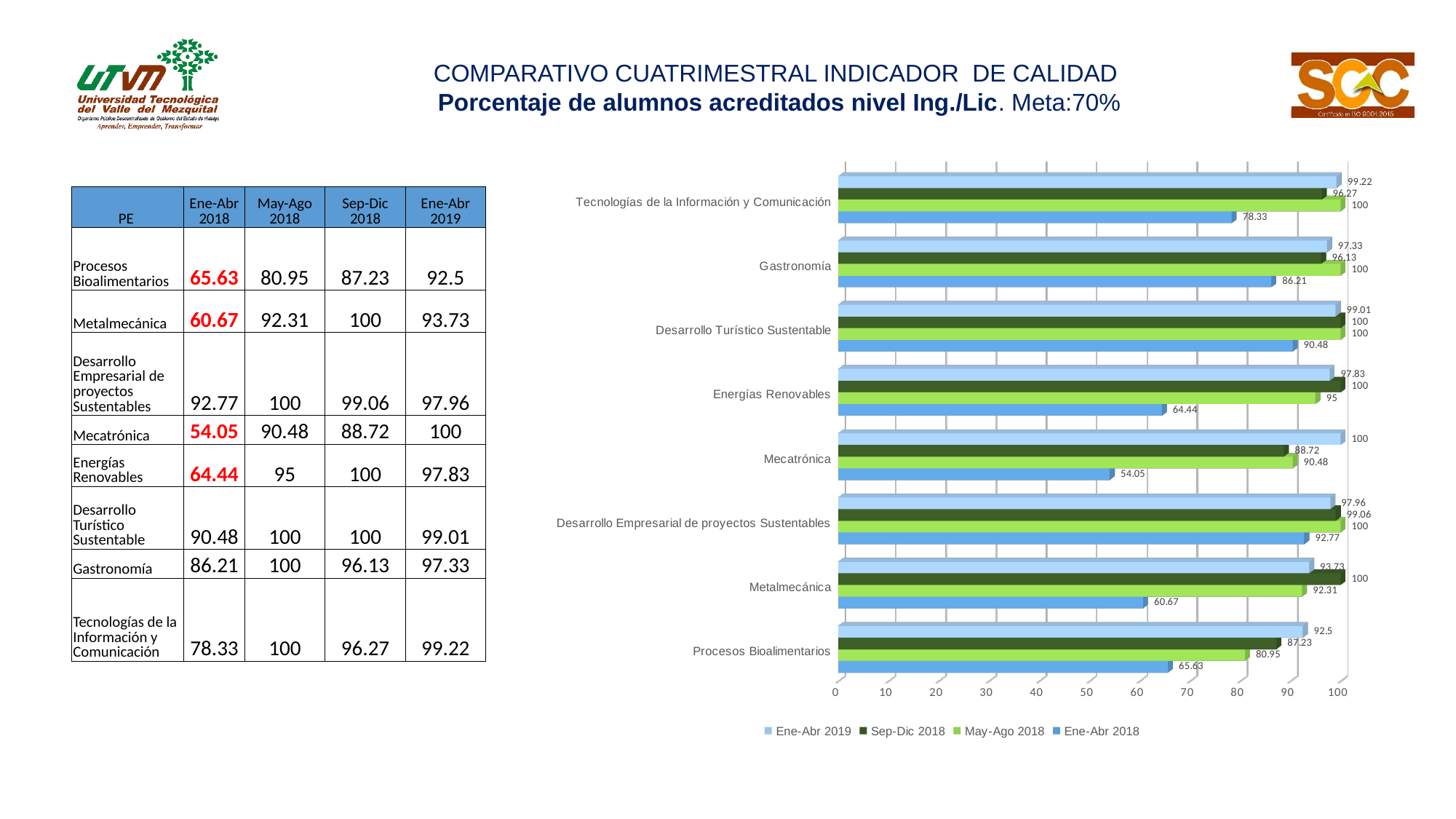
Is the Ene-Abr 2018 value for Energías Renovables greater or less than 70? less Which category has the highest Ene-Abr 2018 value in the chart? Desarrollo Empresarial de proyectos Sustentables How many series does the chart legend list? 4 What is the difference between the Ene-Abr 2019 and Ene-Abr 2018 values for Mecatrónica? 45.95 What kind of chart is shown on the slide? Bar chart Which is larger for Metalmecánica: the Ene-Abr 2019 value or the May-Ago 2018 value? Ene-Abr 2019 How many categories (programs) are plotted on the chart? 8 Which category has the lowest Ene-Abr 2018 value in the chart? Mecatrónica What is the Ene-Abr 2019 value for Tecnologías de la Información y Comunicación in the chart? 99.22 What is the Sep-Dic 2018 value for Procesos Bioalimentarios in the chart? 87.23 What is the Ene-Abr 2018 value for Mecatrónica in the chart? 54.05 Which series is listed first in the chart legend? Ene-Abr 2019